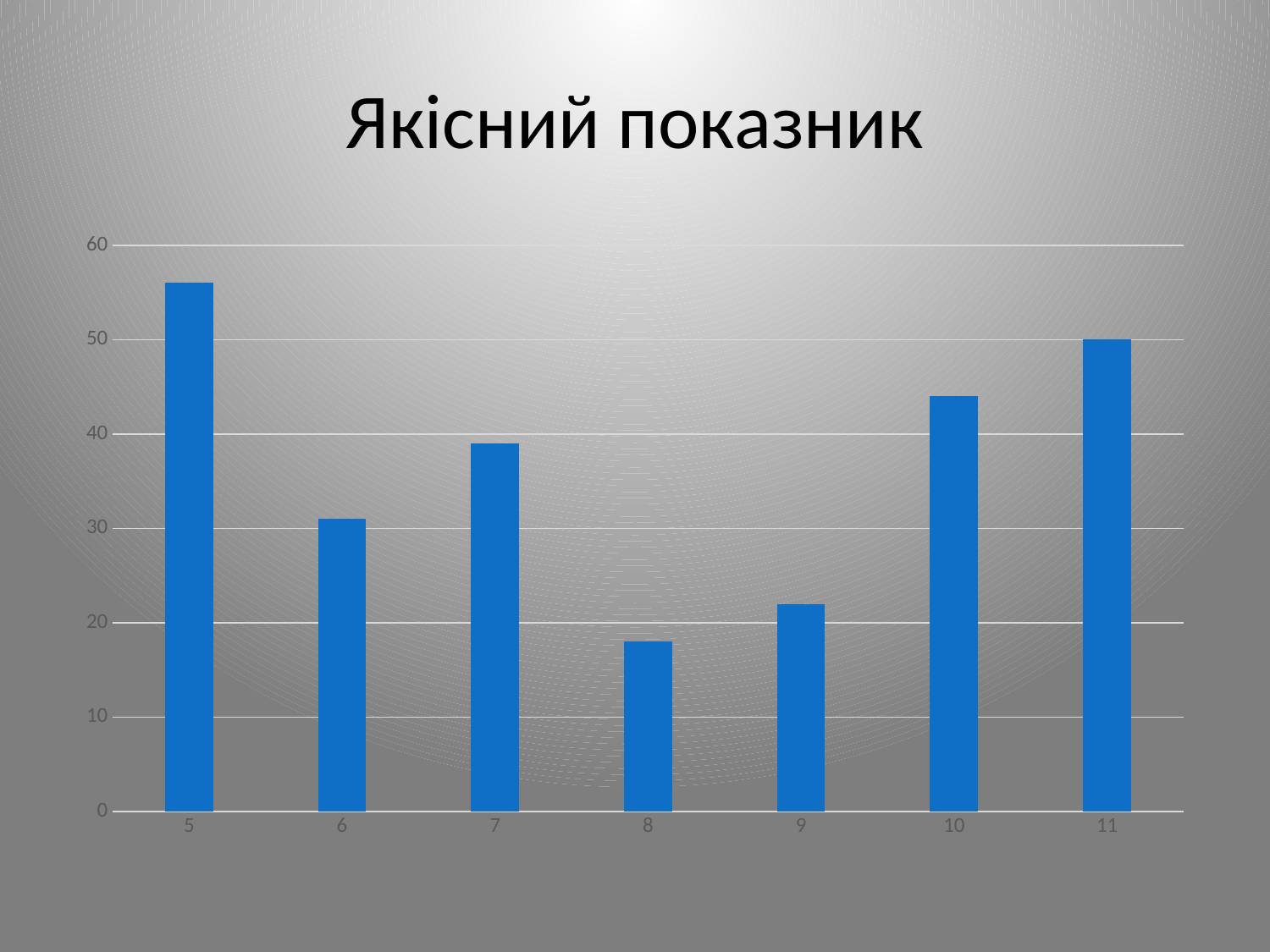
What is the value for category 11? 50 Is the value for category 9 greater or less than 30? less How many bars (categories) are plotted in the chart? 7 What is the title of the chart? Якісний показник What kind of chart is shown on the slide? bar chart Which is larger, the value for category 6 or the value for category 7? 7 Which category has the lowest bar? 8 Is the value for category 8 greater or less than 20? less Is the value for category 5 greater or less than 50? greater Which is larger, the value for category 10 or the value for category 11? 11 Which category has the highest bar? 5